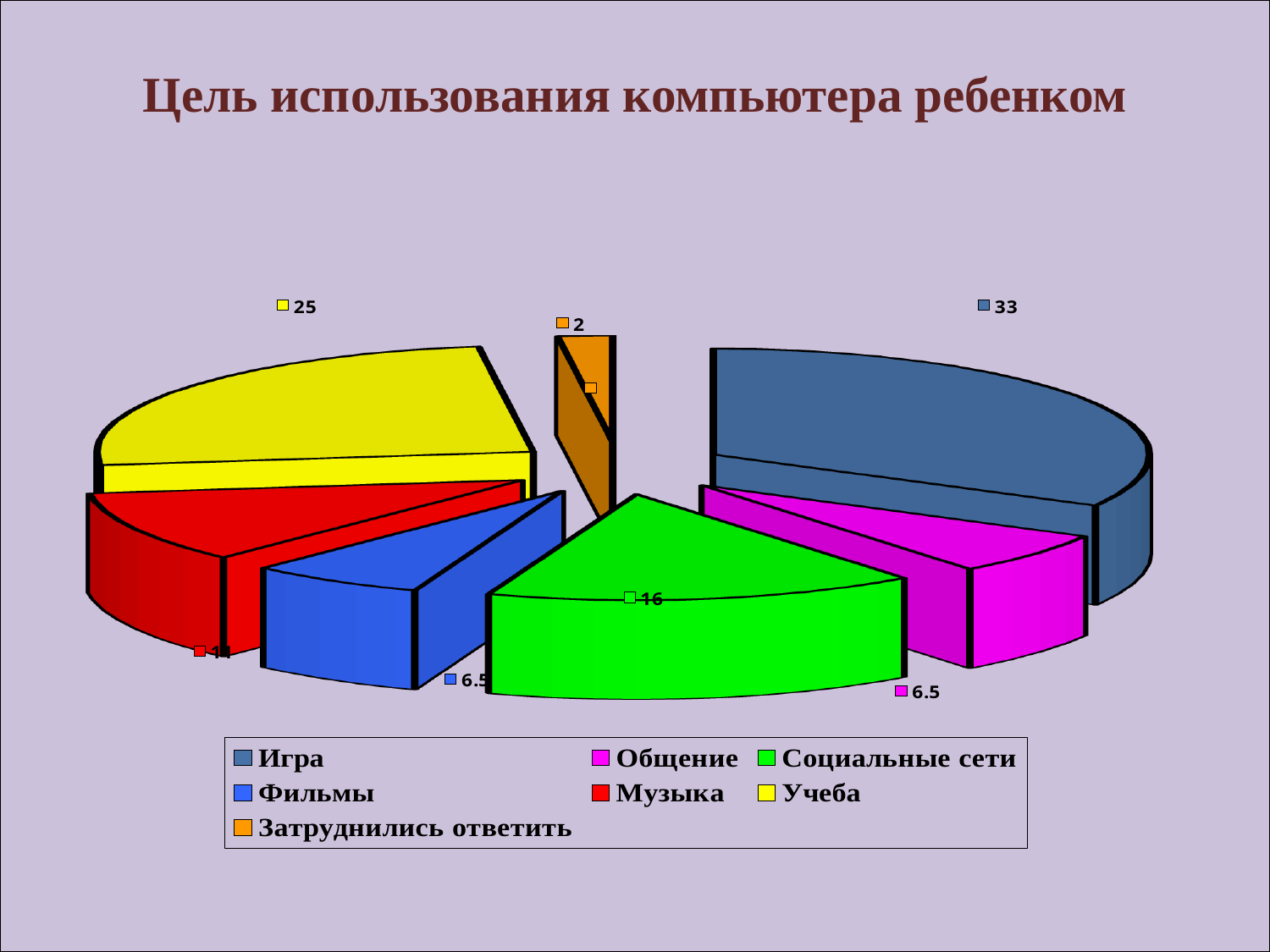
Which category has the smallest slice? Затруднились ответить What is the title of the chart? Цель использования компьютера ребенком What is the value for Фильмы? 6.5 What is the value for Социальные сети? 16 What is the value for Затруднились ответить? 2 What is the difference between the values for Игра and Учеба? 8 How many categories does the legend list? 7 Which is larger, Учеба or Социальные сети? Учеба What is the value for Игра? 33 Which category has the largest slice? Игра What is the value for Учеба? 25 What kind of chart is shown on the slide? Pie chart